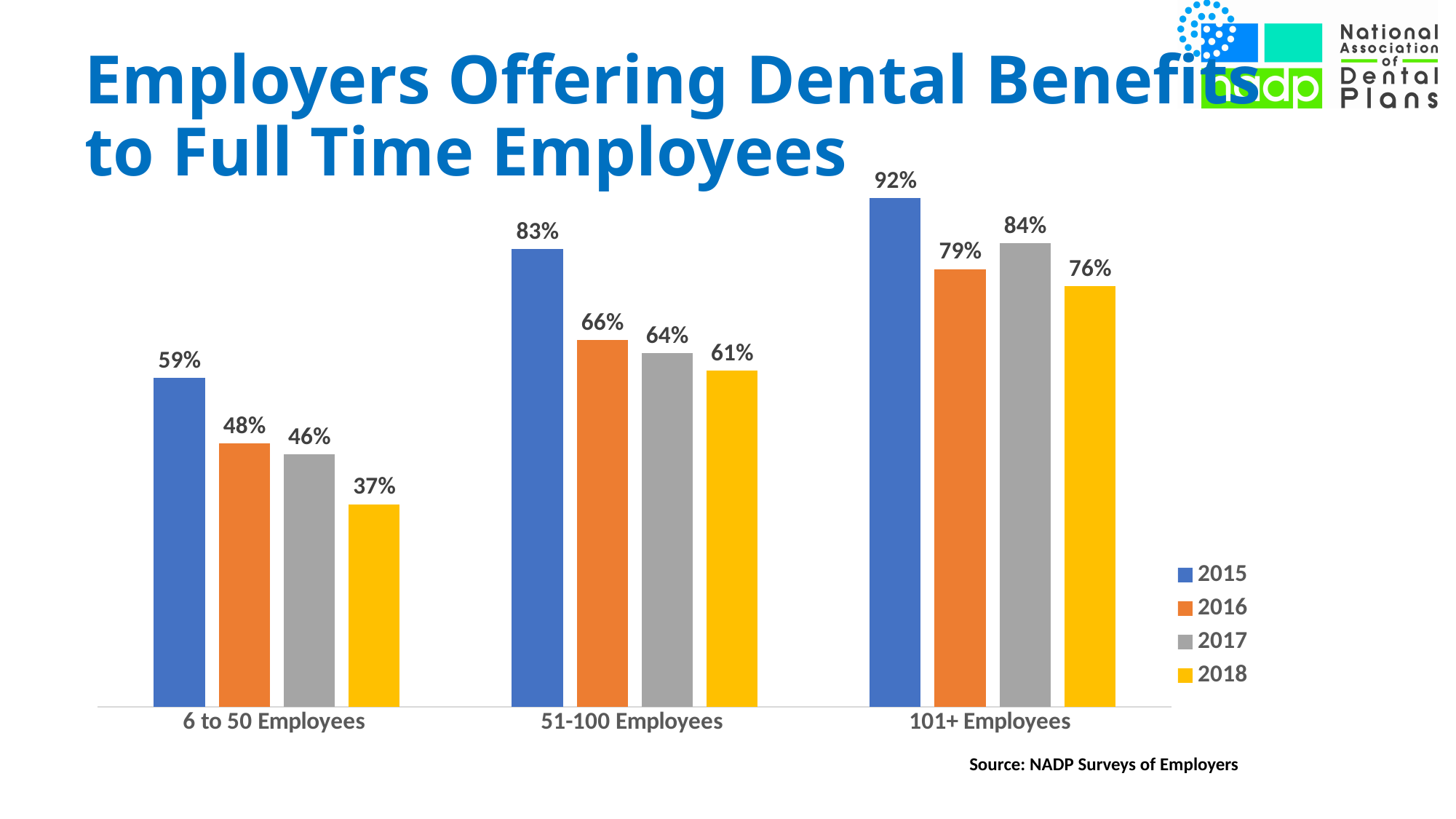
What percentage of employers with 6 to 50 employees offered dental benefits in 2018? 37% Do the values for 101+ Employees rise or fall from 2015 to 2016? Fall What kind of chart is shown on the slide? Bar chart What is the difference between the 2015 and 2018 values for 6 to 50 Employees? 22% Which employer size category has the highest value in 2016? 101+ Employees What is the difference between the 2015 and 2016 values for 101+ Employees? 13% Which year has the lowest value for 51-100 Employees? 2018 What is the value for 51-100 Employees in 2017? 64% Which is larger: the 2017 value for 51-100 Employees or the 2018 value for 101+ Employees? 2018 value for 101+ Employees How many series does the legend list? 4 What is the value for 101+ Employees in 2015? 92% How many employer size categories are shown on the x axis? 3